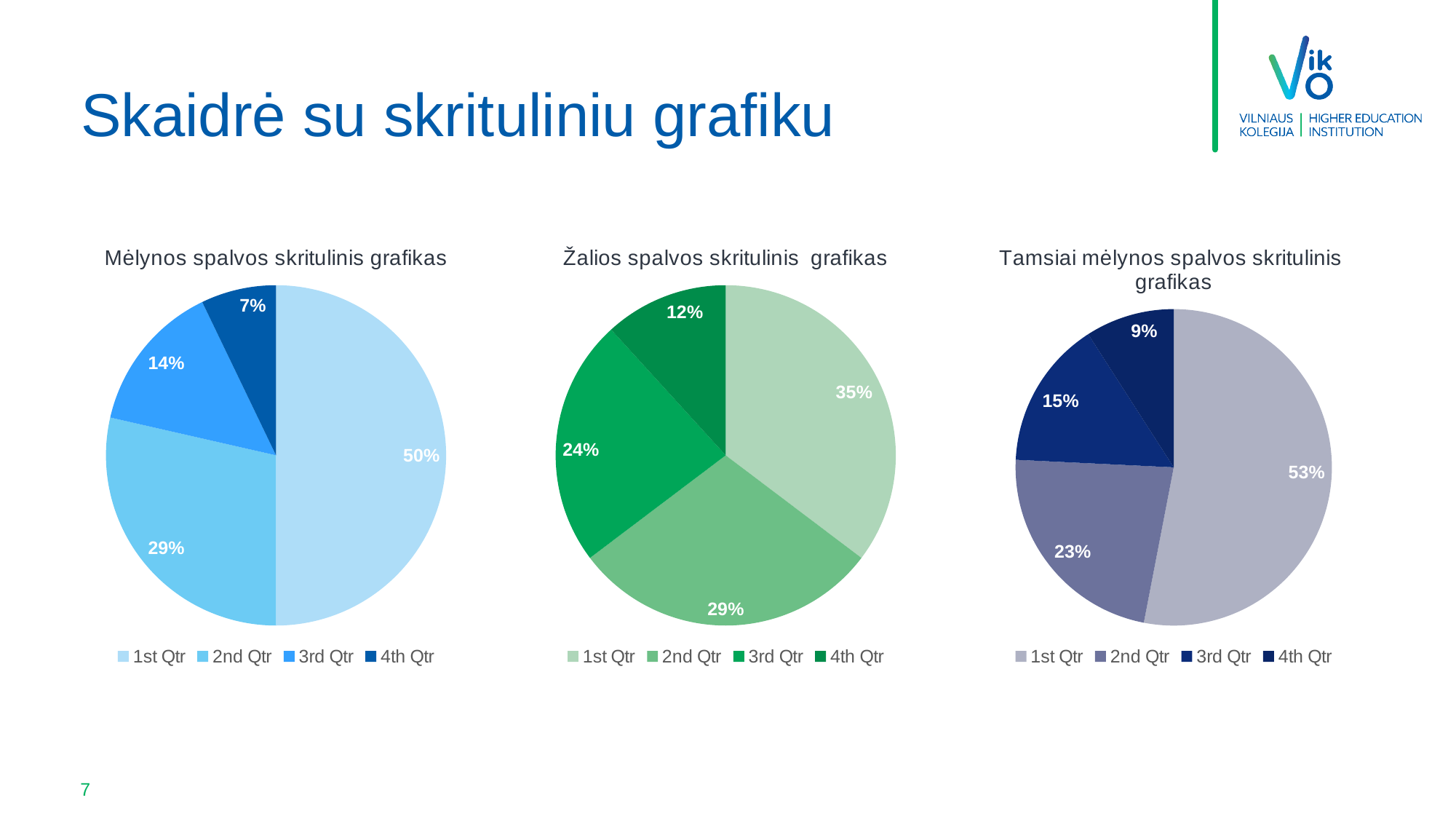
In the chart titled 'Tamsiai mėlynos spalvos skritulinis grafikas', what is the difference between the 1st Qtr and 3rd Qtr shares? 38% In the chart titled 'Tamsiai mėlynos spalvos skritulinis grafikas', which quarter has the smallest slice? 4th Qtr In the chart titled 'Žalios spalvos skritulinis grafikas', which quarter has the largest slice? 1st Qtr In the chart titled 'Mėlynos spalvos skritulinis grafikas', what is the difference between the 2nd Qtr and 3rd Qtr shares? 15% In the chart titled 'Žalios spalvos skritulinis grafikas', which is larger, 2nd Qtr or 4th Qtr? 2nd Qtr What type of chart is the chart titled 'Mėlynos spalvos skritulinis grafikas'? Pie chart How many pie charts are shown on the slide? 3 In the chart titled 'Tamsiai mėlynos spalvos skritulinis grafikas', what share does 2nd Qtr have? 23% How many slices does the chart titled 'Žalios spalvos skritulinis grafikas' have? 4 In the chart titled 'Mėlynos spalvos skritulinis grafikas', which quarter has the smallest slice? 4th Qtr In the chart titled 'Žalios spalvos skritulinis grafikas', what share does 3rd Qtr have? 24% In the chart titled 'Mėlynos spalvos skritulinis grafikas', what share does 1st Qtr have? 50%